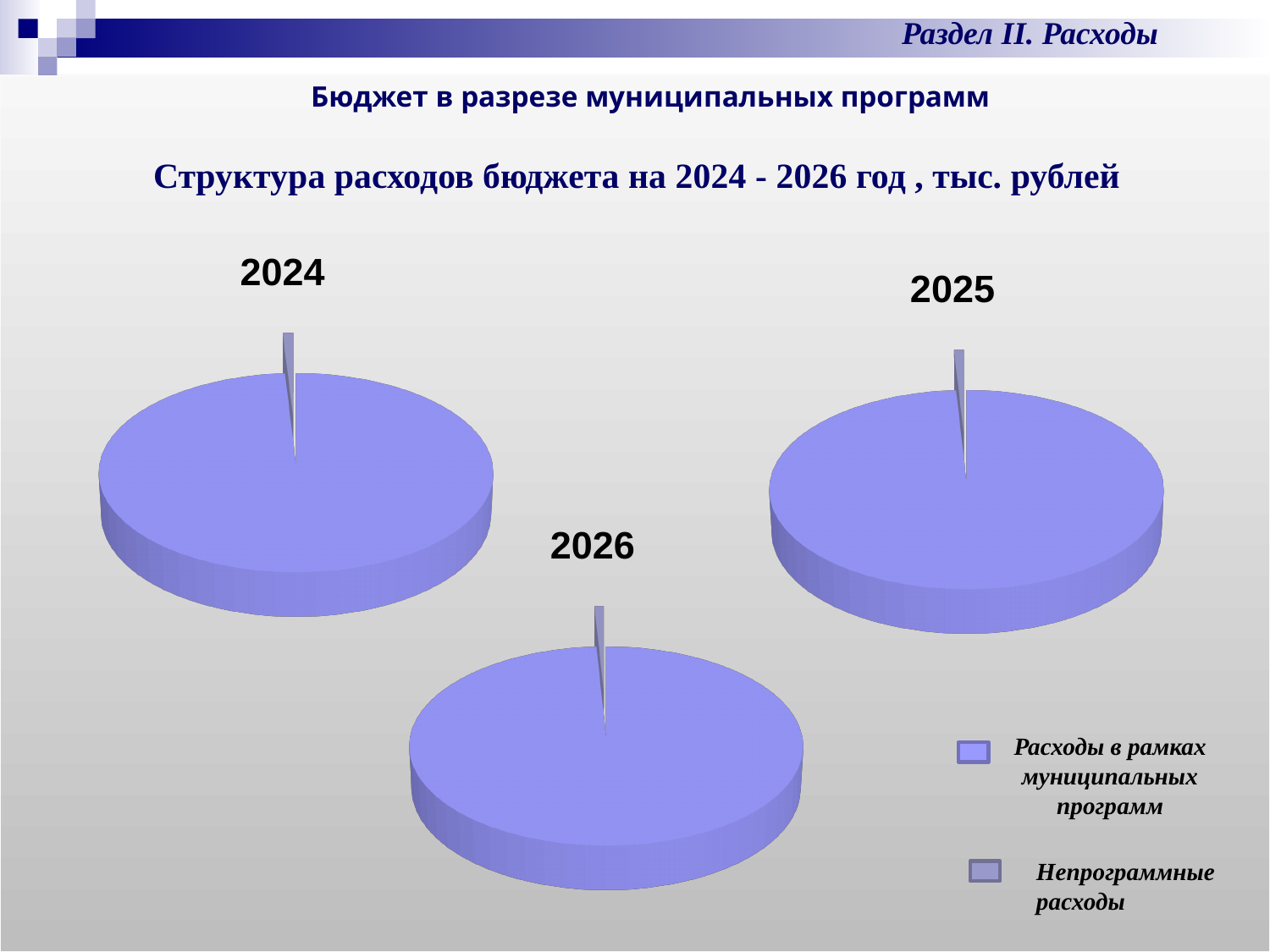
What kind of chart is used for the 2024 data on this slide? pie chart What unit of measurement is stated in the chart title? тыс. рублей How many categories does the legend list? 2 How many slices does each pie chart contain? 2 In the 2024 pie chart, which category has the smallest slice? Непрограммные расходы In the 2025 pie chart, which category has the smallest slice? Непрограммные расходы How many pie charts are shown on the slide? 3 In the 2026 pie chart, which is larger: Расходы в рамках муниципальных программ or Непрограммные расходы? Расходы в рамках муниципальных программ In the 2024 pie chart, which category has the largest slice? Расходы в рамках муниципальных программ In the 2025 pie chart, which category has the largest slice? Расходы в рамках муниципальных программ Which years are shown as pie chart titles on the slide? 2024, 2025, 2026